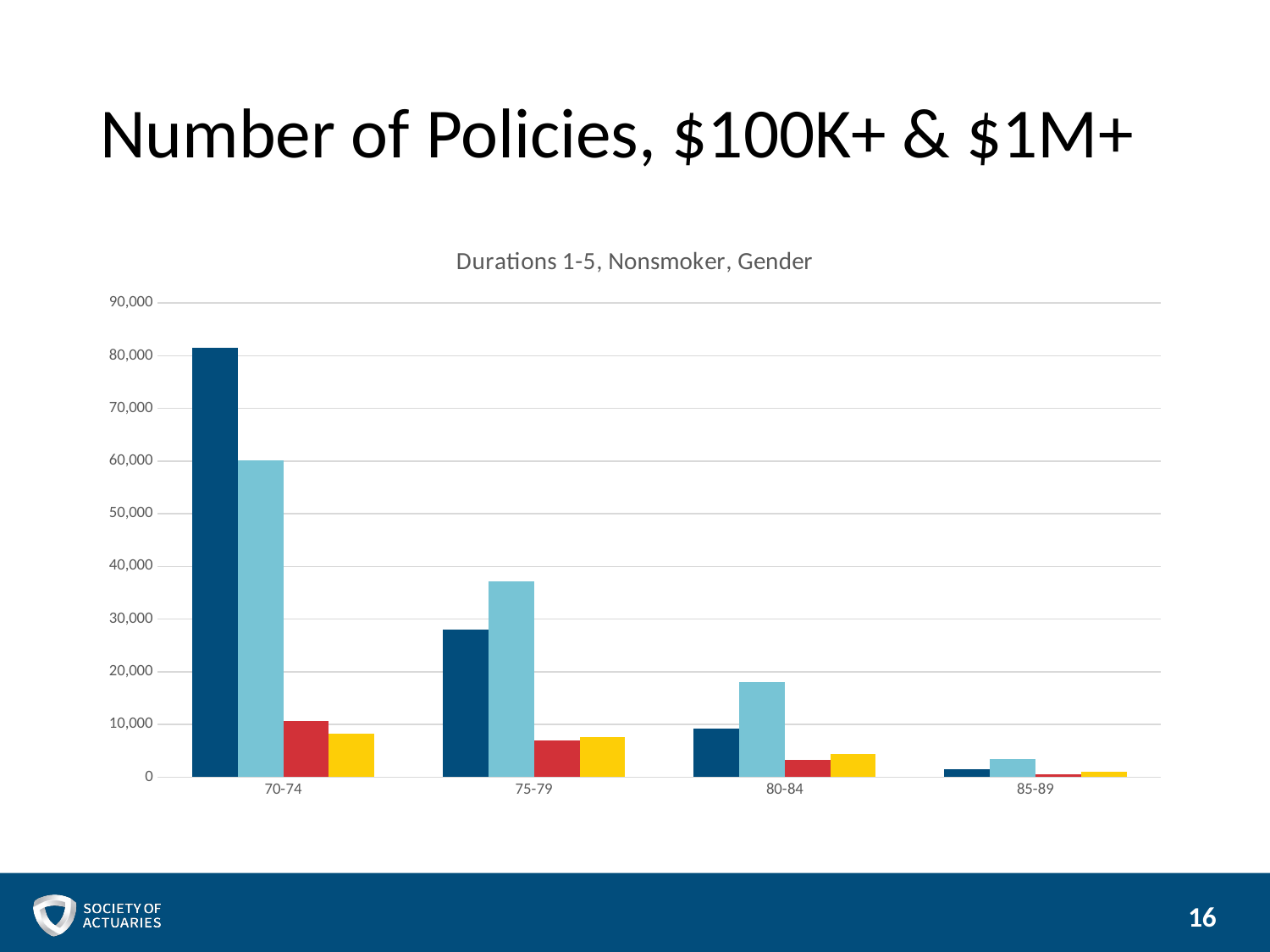
Is the dark blue bar for 70-74 greater or less than 70,000? greater Which age group has the tallest bar overall? 70-74 Is the light blue bar for 80-84 greater or less than 20,000? less How many bars are plotted for each age group? 4 What subtitle appears above the chart? Durations 1-5, Nonsmoker, Gender Is the light blue bar for 75-79 greater or less than 30,000? greater Which age group has the lowest bars overall? 85-89 For the 75-79 age group, which is larger: the dark blue bar or the light blue bar? the light blue bar Do the bar heights generally rise or fall moving from 70-74 to 85-89? fall What kind of chart is shown on the slide? bar chart How many age-group categories are shown on the x axis? 4